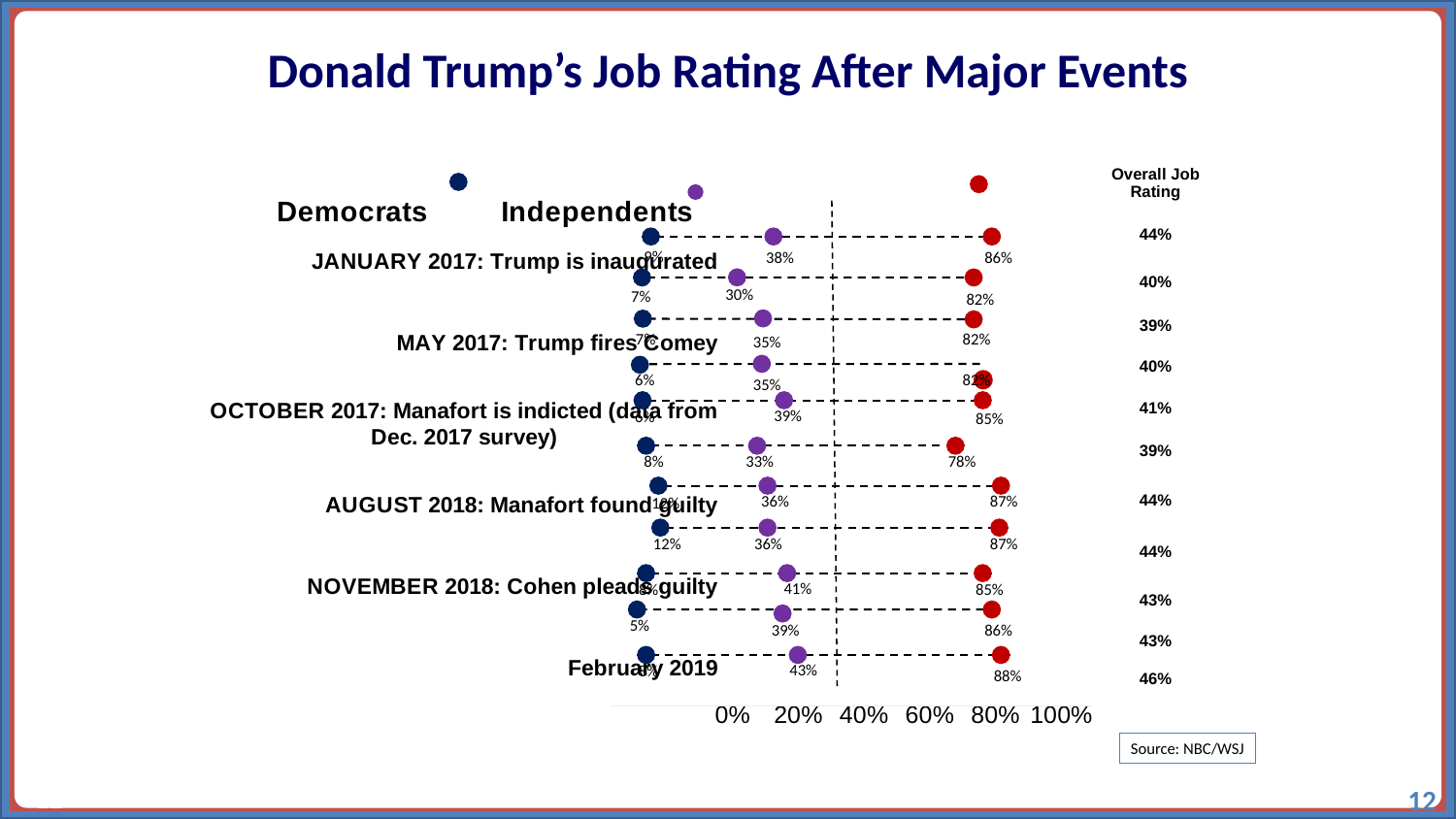
Which row has the highest Overall Job Rating? February 2019 What is the Overall Job Rating listed for JANUARY 2017: Trump is inaugurated? 44% What is the value of the red dot in the row for February 2019? 88% What kind of chart is this? Dot plot What is the lowest Independents value shown on the chart? 30% Is the Democrats value in the February 2019 row greater or less than 20%? less What is the Independents value in the row for February 2019? 43% What is the Overall Job Rating listed for February 2019? 46% What is the title of the chart? Donald Trump's Job Rating After Major Events In the February 2019 row, what is the difference between the red dot value and the Independents value? 45 percentage points What is the highest Independents value shown on the chart? 43% What is the Independents value in the row for JANUARY 2017: Trump is inaugurated? 38%